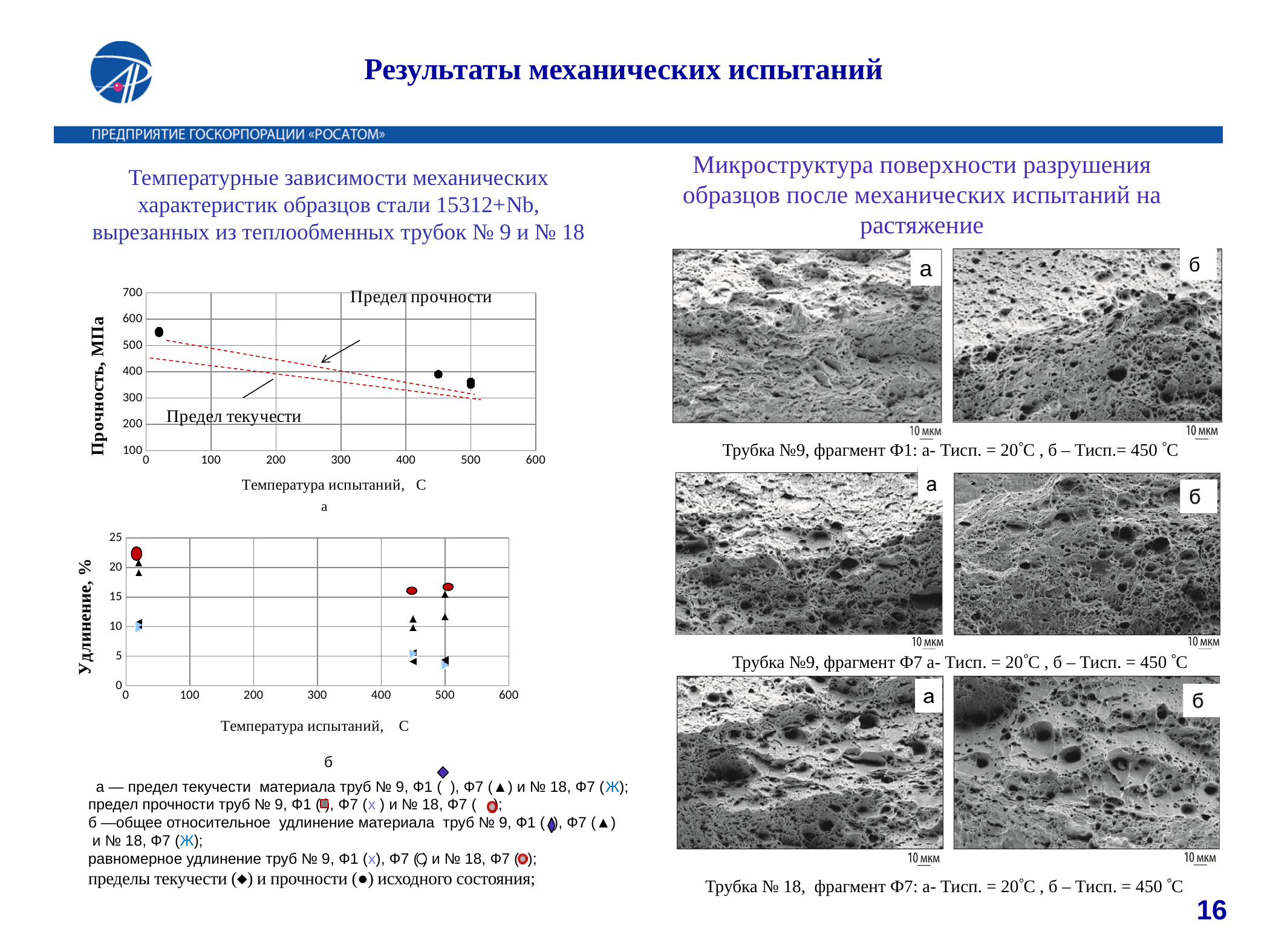
In the lower chart (б), is the elongation value of the red circle at about 20 °C greater or less than 20? greater What kind of chart is the upper chart (а) on the left of the slide? scatter chart In the upper chart (а), which of the two dashed lines lies higher: 'Предел прочности' or 'Предел текучести'? Предел прочности In the upper chart (а), is the strength value of the black point at about 20 °C greater or less than 500? greater In the lower chart (б), what is the label of the vertical axis? Удлинение, % In the lower chart (б), is the elongation value of the red circle at about 450 °C greater or less than 20? less In the lower chart (б), do the red-circle elongation values rise or fall as the test temperature increases from 20 °C to 450 °C? fall What kind of chart is the lower chart (б) on the left of the slide? scatter chart In the upper chart (а), what is the label of the vertical axis? Прочность, МПа In the upper chart (а), do the plotted strength values rise or fall as the test temperature increases? fall